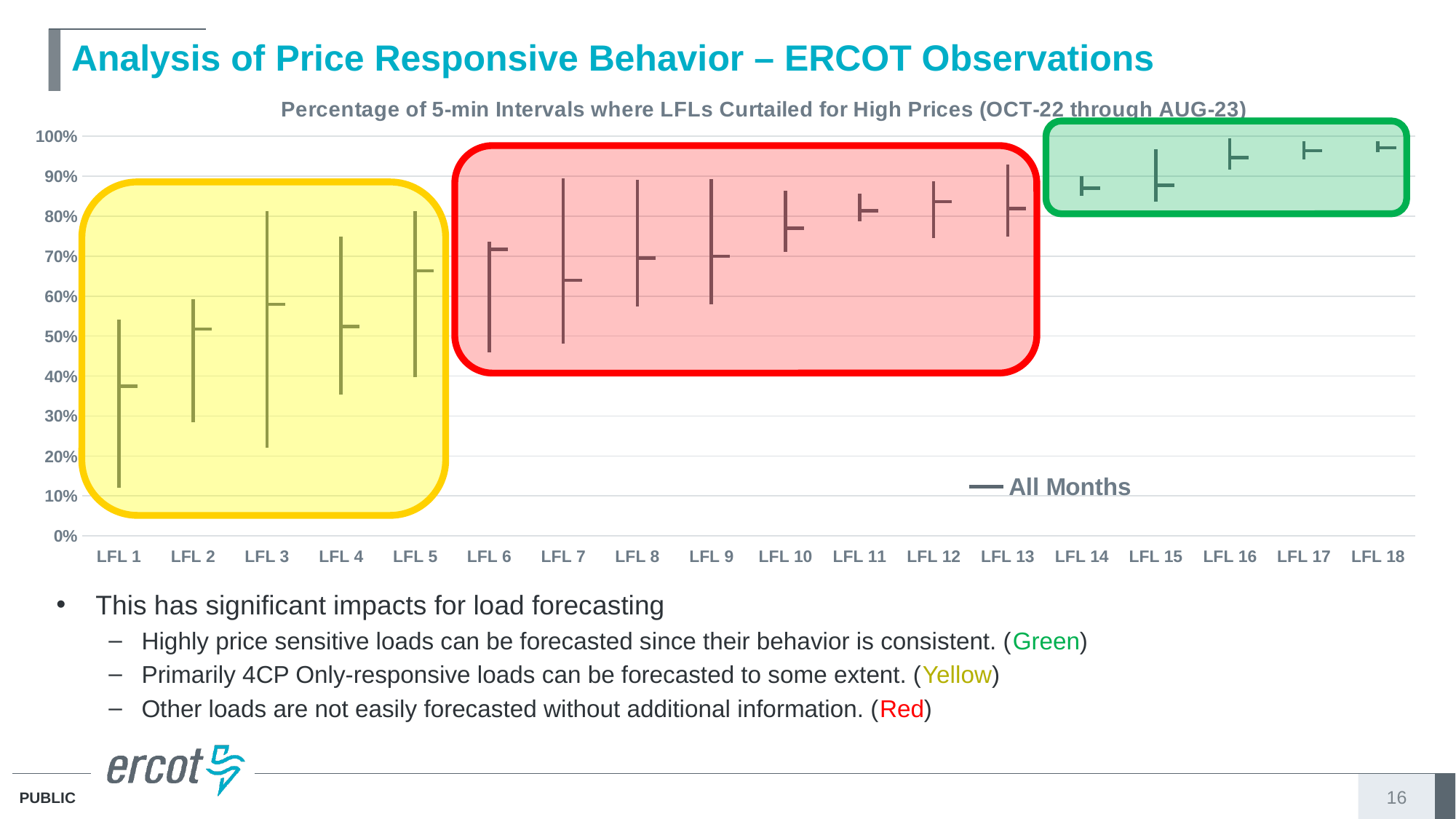
What is the name of the series shown in the chart legend? All Months Which LFL has the highest marker value in the chart? LFL 18 Is the marker value for LFL 14 greater or less than 80%? greater Is the marker value for LFL 18 greater or less than 90%? greater Which has the larger marker value, LFL 2 or LFL 17? LFL 17 Is the marker value for LFL 1 greater or less than 50%? less How many LFL categories are shown on the x axis of the chart? 18 Which LFL has the lowest marker value in the chart? LFL 1 How many series does the chart legend list? 1 What is the title of the chart? Percentage of 5-min Intervals where LFLs Curtailed for High Prices (OCT-22 through AUG-23) Do the marker values generally rise or fall moving from LFL 1 to LFL 18 along the x axis? rise